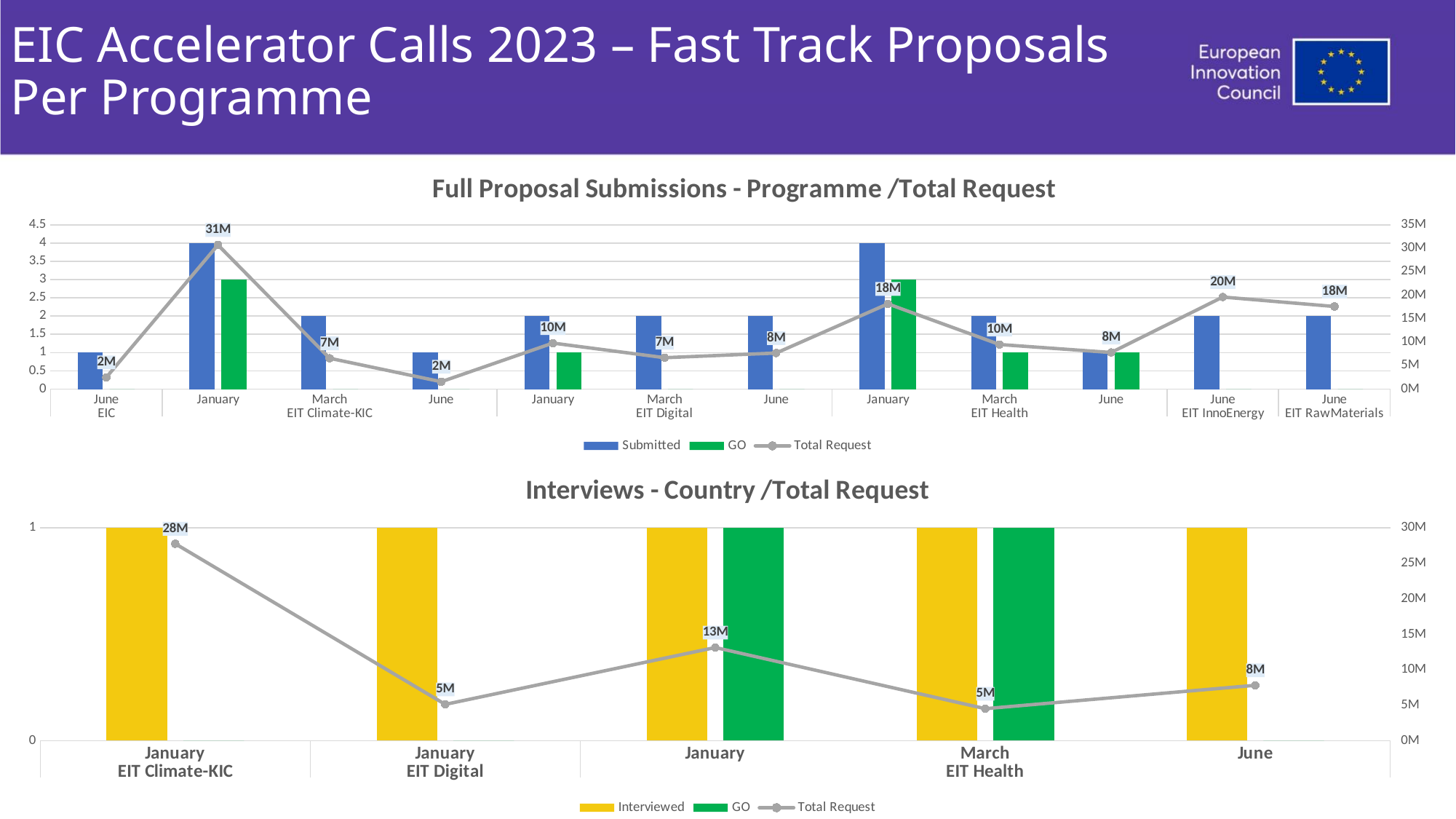
In the 'Full Proposal Submissions - Programme /Total Request' chart, which category has the highest Total Request? January EIT Climate-KIC In the 'Full Proposal Submissions - Programme /Total Request' chart, what is the Total Request for January EIT Climate-KIC? 31M In the 'Interviews - Country /Total Request' chart, what is the Total Request for January EIT Climate-KIC? 28M In the 'Full Proposal Submissions - Programme /Total Request' chart, is the Total Request for March EIT Digital larger or smaller than for June EIT RawMaterials? smaller In the 'Full Proposal Submissions - Programme /Total Request' chart, how many categories are shown on the x axis? 12 In the 'Full Proposal Submissions - Programme /Total Request' chart, what is the Total Request for June EIT InnoEnergy? 20M In the 'Full Proposal Submissions - Programme /Total Request' chart, how many series does the legend list? 3 In the 'Interviews - Country /Total Request' chart, what colour are the Interviewed bars? Yellow In the 'Interviews - Country /Total Request' chart, what is the difference between the Total Request for January EIT Climate-KIC and January EIT Health? 15M In the 'Interviews - Country /Total Request' chart, which category has the highest Total Request? January EIT Climate-KIC In the 'Full Proposal Submissions - Programme /Total Request' chart, what is the difference between the Total Request for January EIT Climate-KIC and January EIT Health? 13M In the 'Interviews - Country /Total Request' chart, what is the Total Request for January EIT Health? 13M